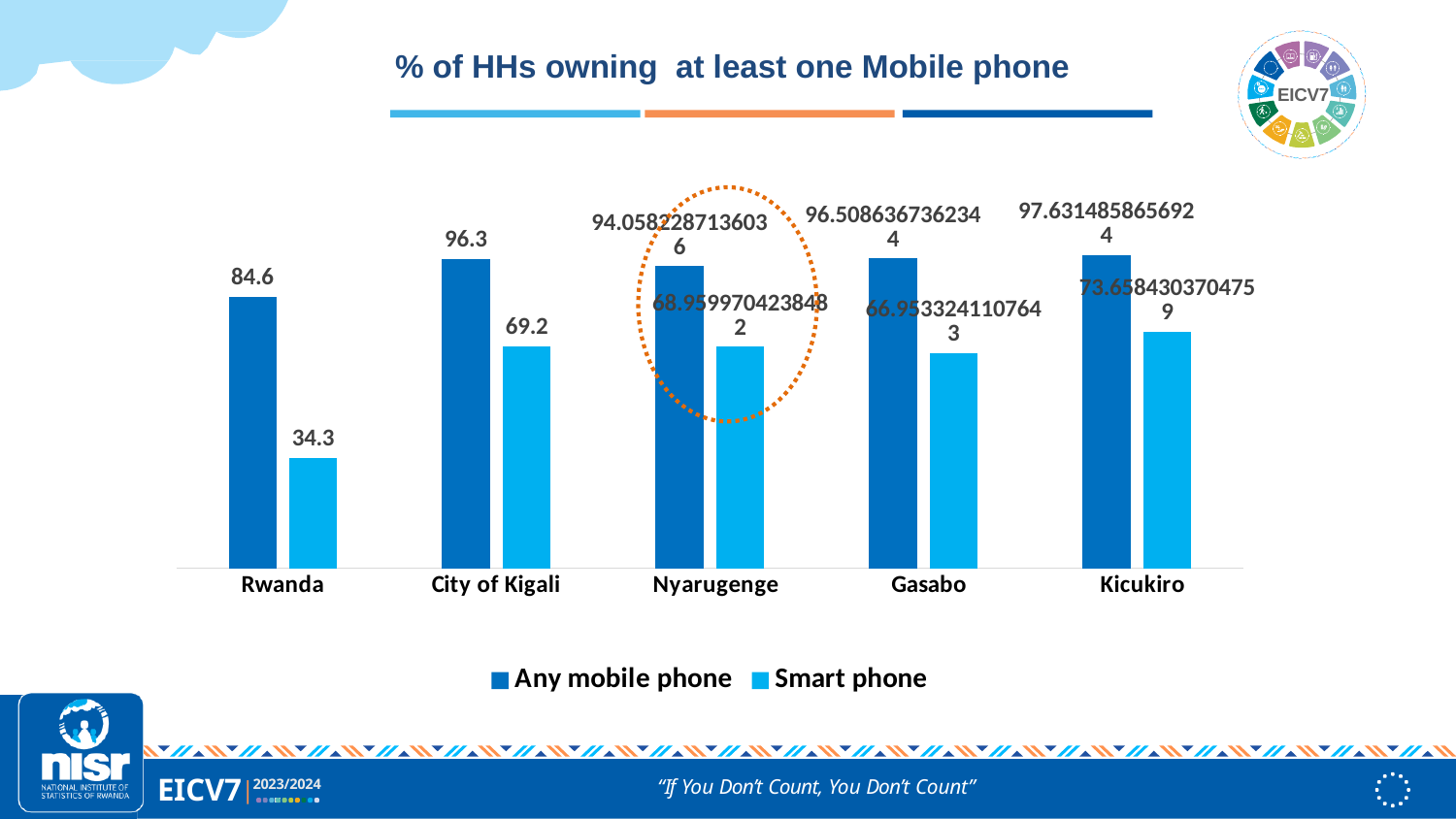
What is the difference between the Any mobile phone values for City of Kigali and Rwanda? 11.7 What is the difference between the Any mobile phone and Smart phone values for Rwanda? 50.3 What is the value for Smart phone in Rwanda? 34.3 Which is larger: the Smart phone value for City of Kigali or for Rwanda? City of Kigali What is the value for Any mobile phone in City of Kigali? 96.3 Which category has the lowest Smart phone value? Rwanda How many series does the legend list? 2 Which category has the lowest Any mobile phone value? Rwanda What is the value for Smart phone in City of Kigali? 69.2 How many categories are shown on the x axis? 5 What is the value for Any mobile phone in Rwanda? 84.6 What kind of chart is shown on the slide? Bar chart